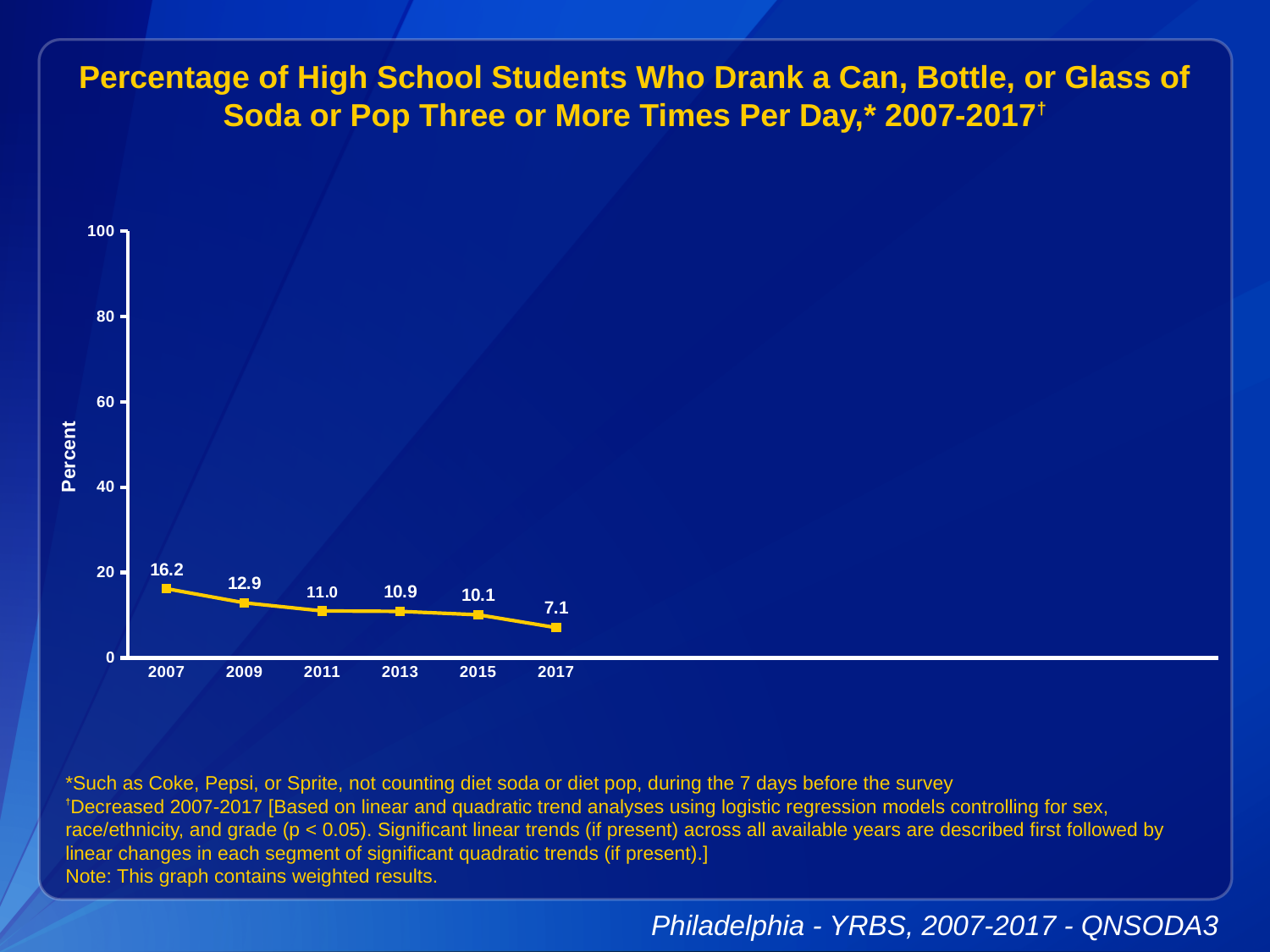
What is the value plotted for 2017? 7.1 What is the value plotted for 2011? 11.0 Is the value for 2007 greater or less than 20? less What is the difference between the 2009 value and the 2011 value? 1.9 What percentage of high school students drank soda or pop three or more times per day in 2007? 16.2 By how many percentage points did the value fall from 2007 to 2017? 9.1 How many years are plotted on the chart? 6 Which year has the lowest percentage? 2017 Which year has the highest percentage? 2007 Do the values rise or fall from 2007 to 2017? fall Which year has a larger value, 2009 or 2015? 2009 What kind of chart is shown on the slide? line chart